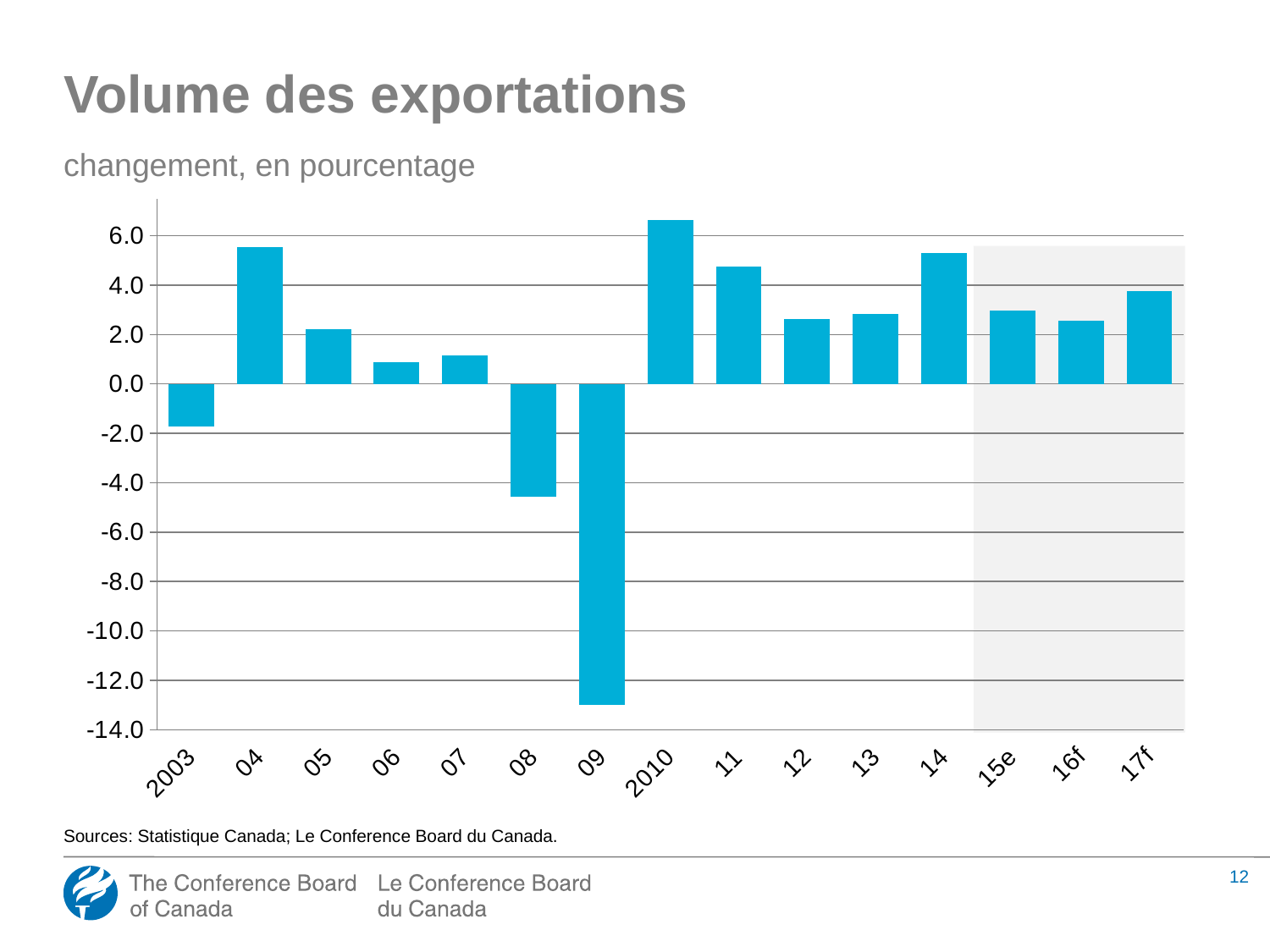
Which is larger, the value for 14 or the value for 13? 14 How many years (bars) are plotted on the chart? 15 Is the value for 04 greater or less than 4.0? greater Is the value for 2010 greater or less than 6.0? greater Which year has the lowest export volume change? 09 Is the value for 08 greater or less than -2.0? less Which is larger, the value for 2010 or the value for 11? 2010 Which year has the highest export volume change? 2010 What is the title of the chart? Volume des exportations What kind of chart is shown on the slide? bar chart